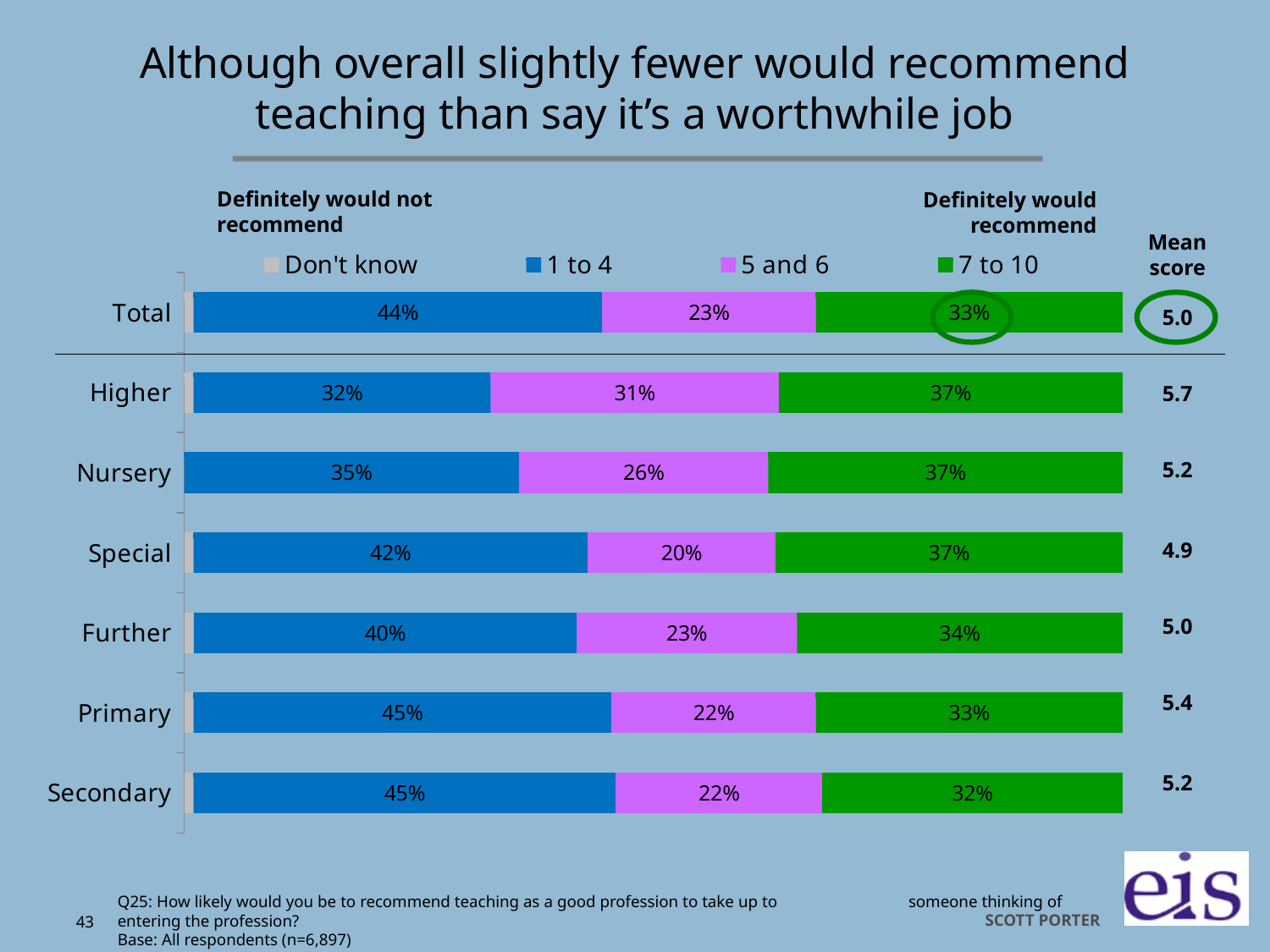
How many series does the legend list? 4 What kind of chart is shown on the slide? Stacked bar chart For Special, which is larger: the '1 to 4' share or the '7 to 10' share? 1 to 4 Which category has the lowest percentage for the '1 to 4' series? Higher What percentage of Further respondents gave a score of 7 to 10? 34% What percentage of Nursery respondents gave a score of 5 and 6? 26% What percentage of Total respondents gave a score of 1 to 4? 44% How many categories (bars) are shown in the chart? 7 For the Total bar, what is the difference between the '1 to 4' share and the '7 to 10' share? 11 percentage points Which category has the lowest percentage for the '7 to 10' series? Secondary What is the mean score shown for Higher? 5.7 Which category has the highest percentage for the '5 and 6' series? Higher